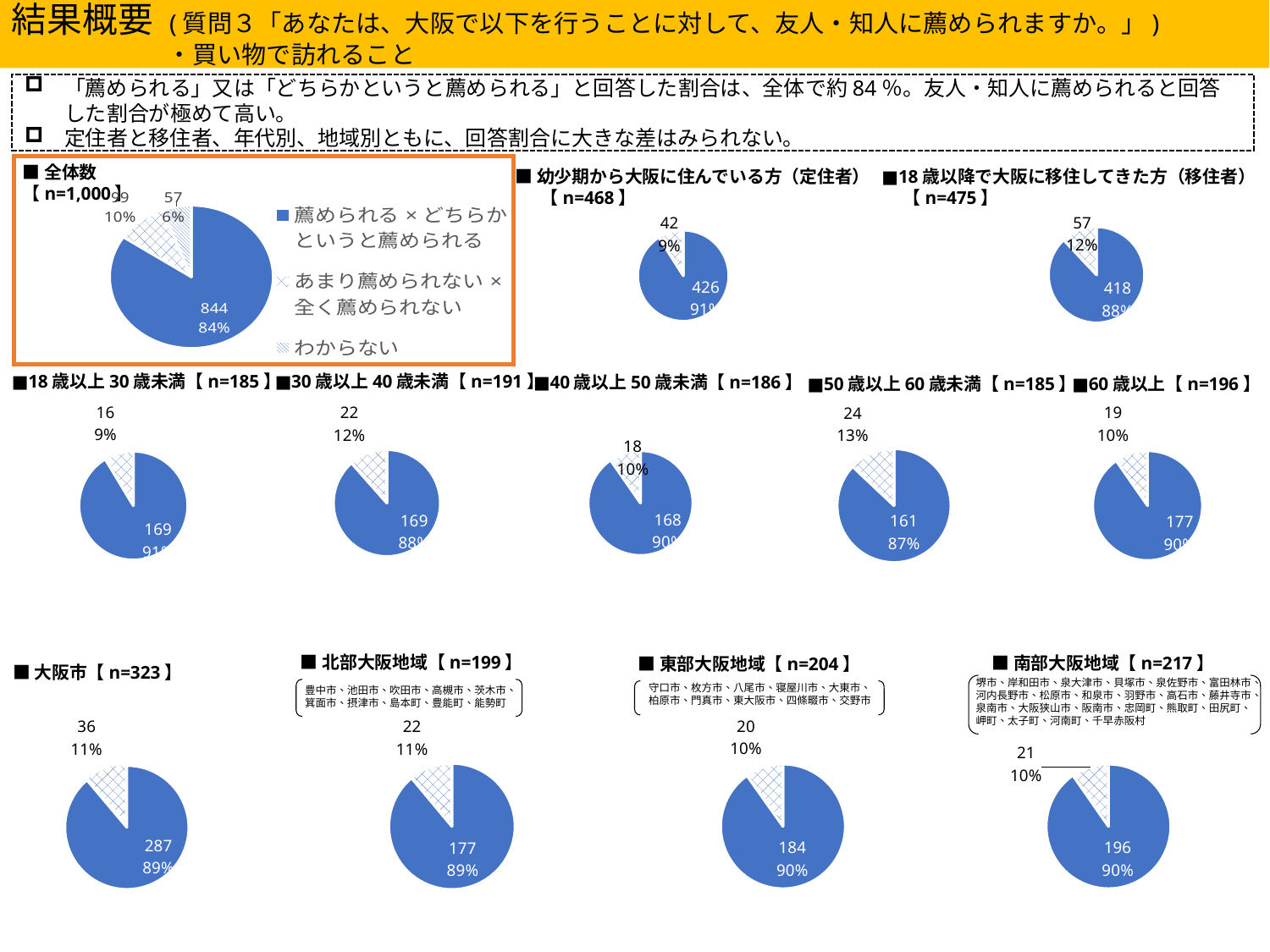
In the 全体数 (n=1,000) pie chart, what value is shown for the largest slice (薦められる × どちらかというと薦められる)? 844 In the 50歳以上60歳未満 (n=185) pie chart, what value is shown for the large blue slice? 161 Among the five age-group pie charts, which group shows the highest percentage for the smaller slice? 50歳以上60歳未満 (13%) Which is larger: the large-slice value in the 大阪市 pie chart or in the 南部大阪地域 pie chart? 大阪市 (287) How many pie charts are shown in the bottom row (regional breakdown) of the slide? 4 How many entries does the legend of the 全体数 pie chart list? 3 What is the difference between the large-slice values of the 定住者 (426) and 移住者 (418) pie charts? 8 In the 東部大阪地域 (n=204) pie chart, what percentage is shown for the smaller slice? 10% In the 幼少期から大阪に住んでいる方（定住者）(n=468) pie chart, what percentage is shown for the large blue slice? 91% In the 18歳以降で大阪に移住してきた方（移住者）(n=475) pie chart, what value is shown for the smaller slice? 57 In the 全体数 (n=1,000) pie chart, what percentage is shown for the わからない slice? 6% What type of chart is used throughout this slide? Pie chart